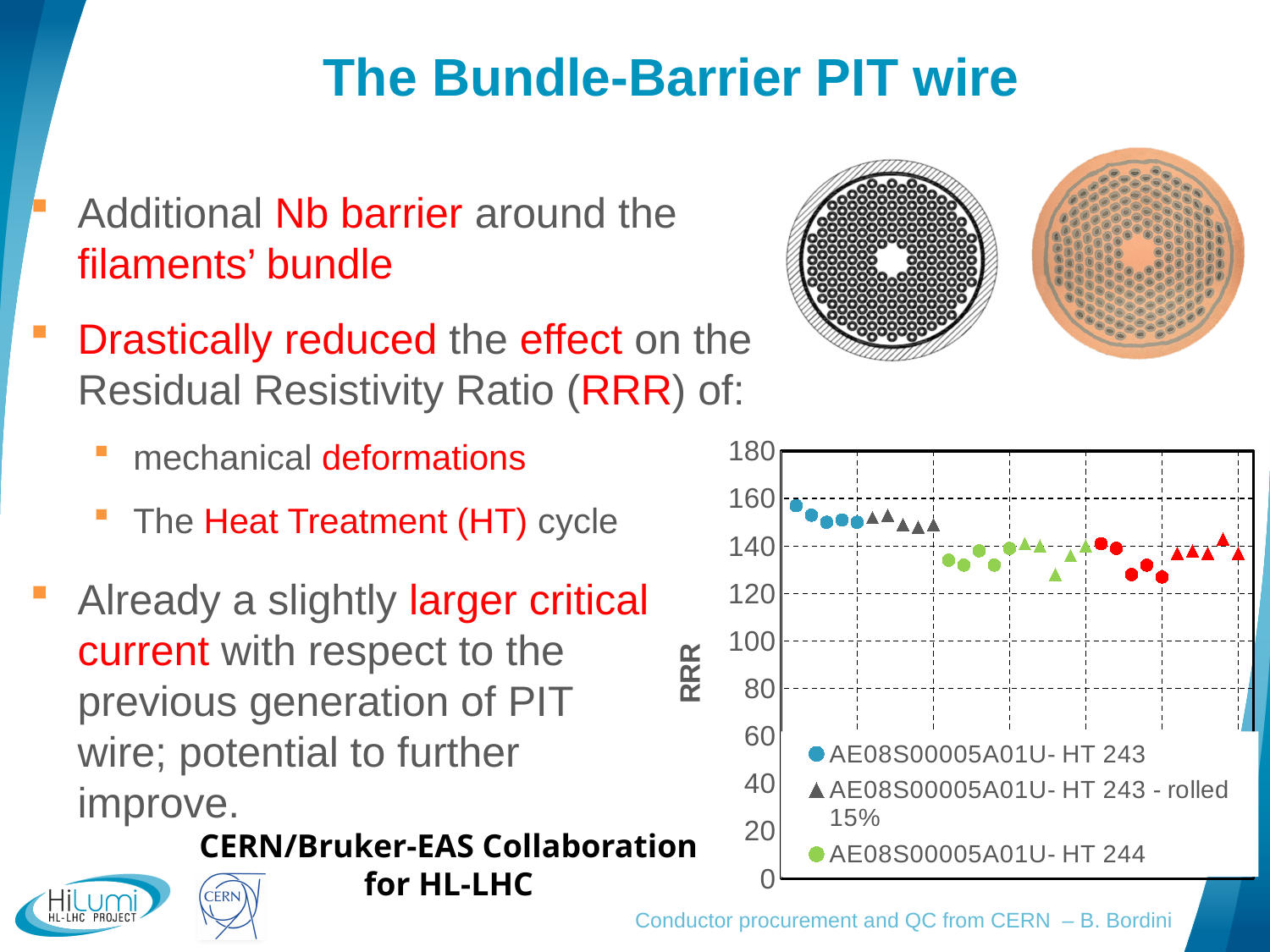
Are the values for the AE08S00005A01U- HT 243 series greater or less than 140? greater Are the values for the AE08S00005A01U- HT 243 - rolled 15% series greater or less than 120? greater What kind of chart is shown on the slide? scatter chart What is the label on the vertical axis of the chart? RRR Do the RRR values for the AE08S00005A01U- HT 243 series rise or fall from left to right? fall What is the maximum value shown on the vertical axis of the chart? 180 Is the lowest plotted value on the chart greater or less than 120? greater Which series has higher RRR values, AE08S00005A01U- HT 243 or AE08S00005A01U- HT 244? AE08S00005A01U- HT 243